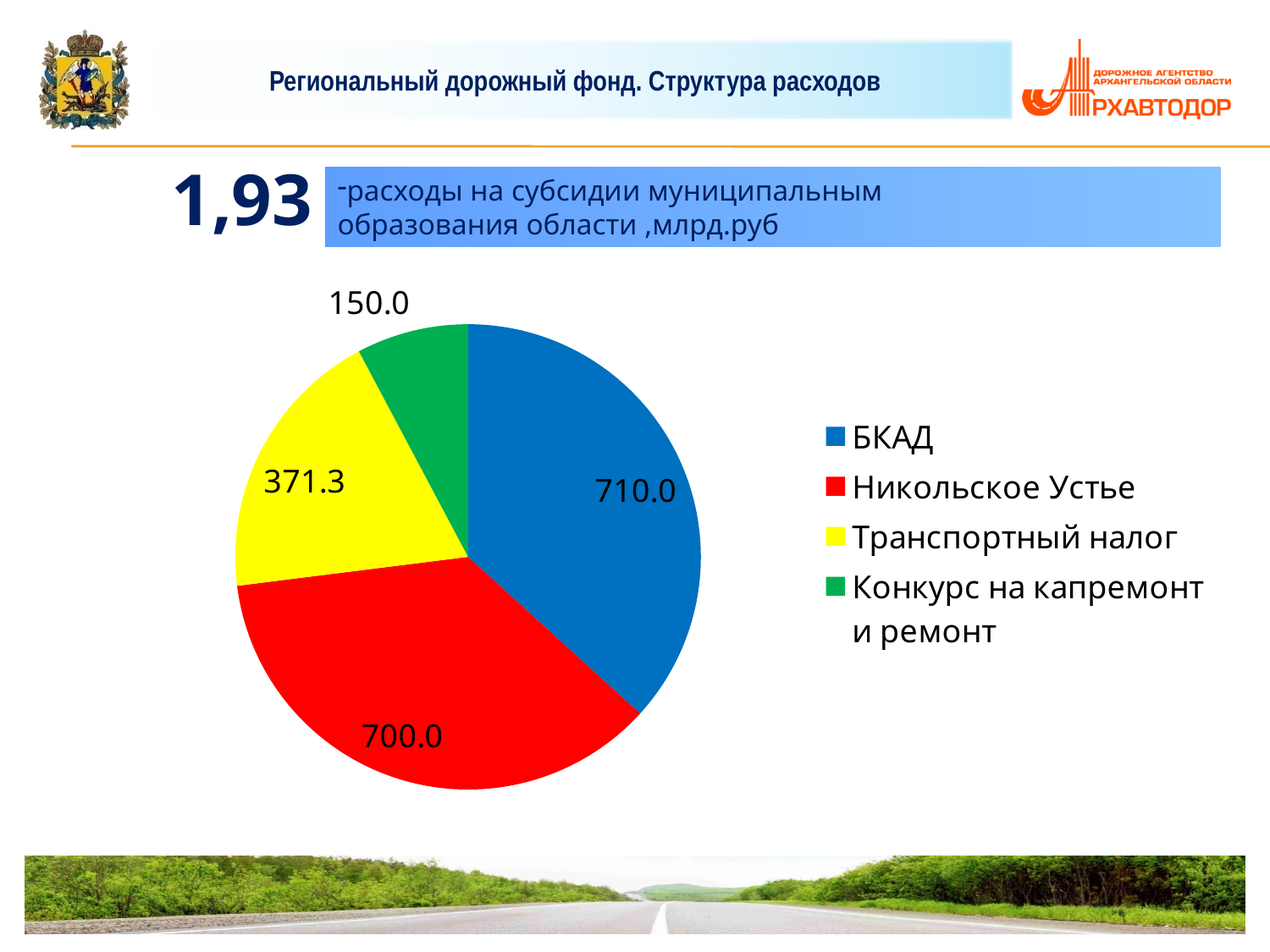
Which category has the smallest slice in the pie chart? Конкурс на капремонт и ремонт How many categories does the pie chart show? 4 What is the value for Никольское Устье in the pie chart? 700.0 What is the value for БКАД in the pie chart? 710.0 Which is larger: the value for Транспортный налог or the value for Конкурс на капремонт и ремонт? Транспортный налог Which category has the largest slice in the pie chart? БКАД What is the value for Транспортный налог in the pie chart? 371.3 What colour is the slice for Транспортный налог? yellow What is the value for Конкурс на капремонт и ремонт in the pie chart? 150.0 What is the difference between the values for Транспортный налог and Конкурс на капремонт и ремонт? 221.3 What kind of chart is shown on the slide? pie chart What is the difference between the values for БКАД and Никольское Устье? 10.0